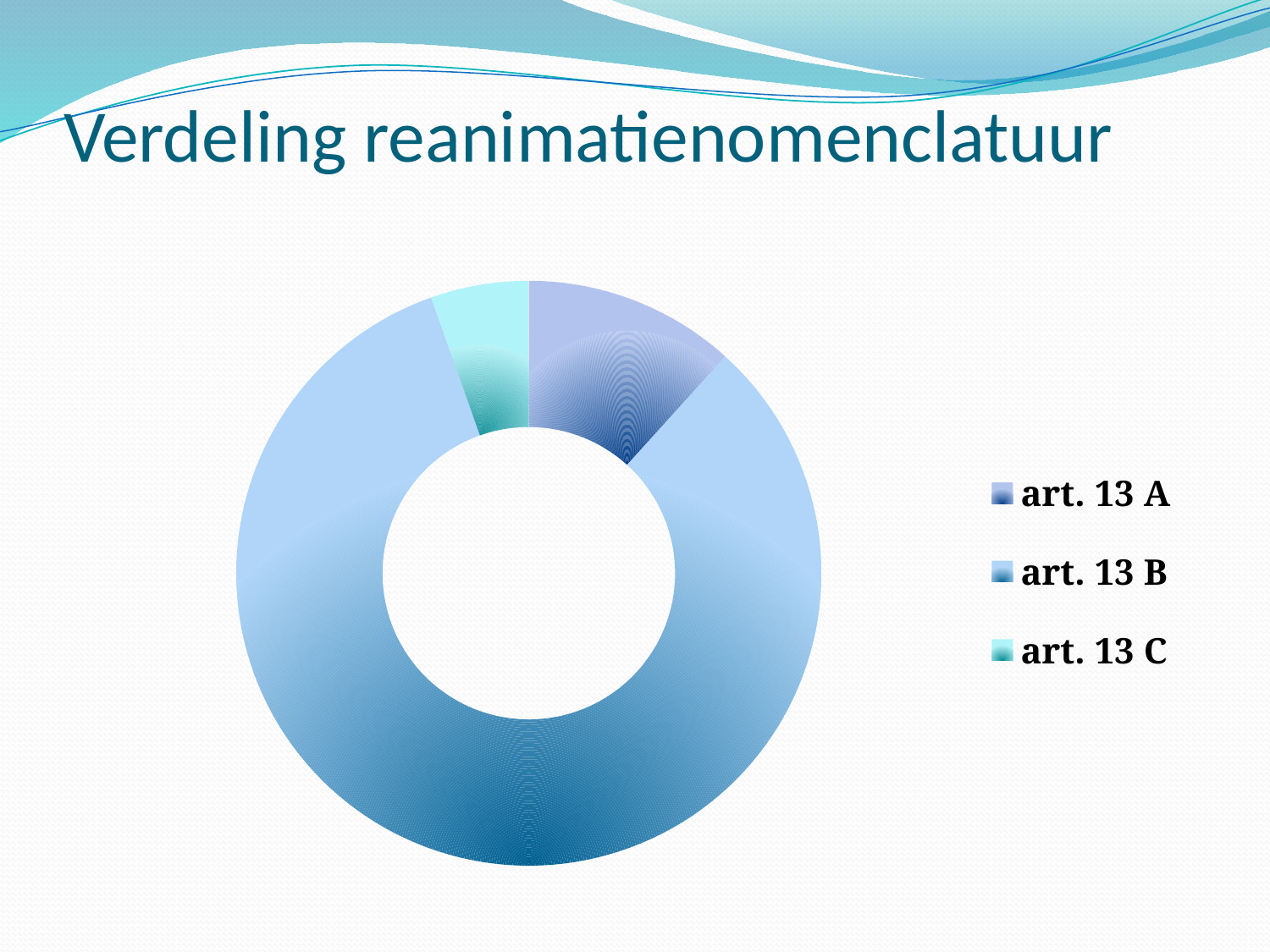
What kind of chart is shown on the slide? Doughnut chart Which category has the smallest share of the doughnut chart? art. 13 C Which is larger, the share for art. 13 A or the share for art. 13 C? art. 13 A What is the title of the slide containing the chart? Verdeling reanimatienomenclatuur Which is larger, the share for art. 13 A or the share for art. 13 B? art. 13 B Does art. 13 B account for more or less than half of the doughnut chart? more Which category has the largest share of the doughnut chart? art. 13 B Which categories are listed in the chart's legend? art. 13 A, art. 13 B, art. 13 C How many categories does the chart show? 3